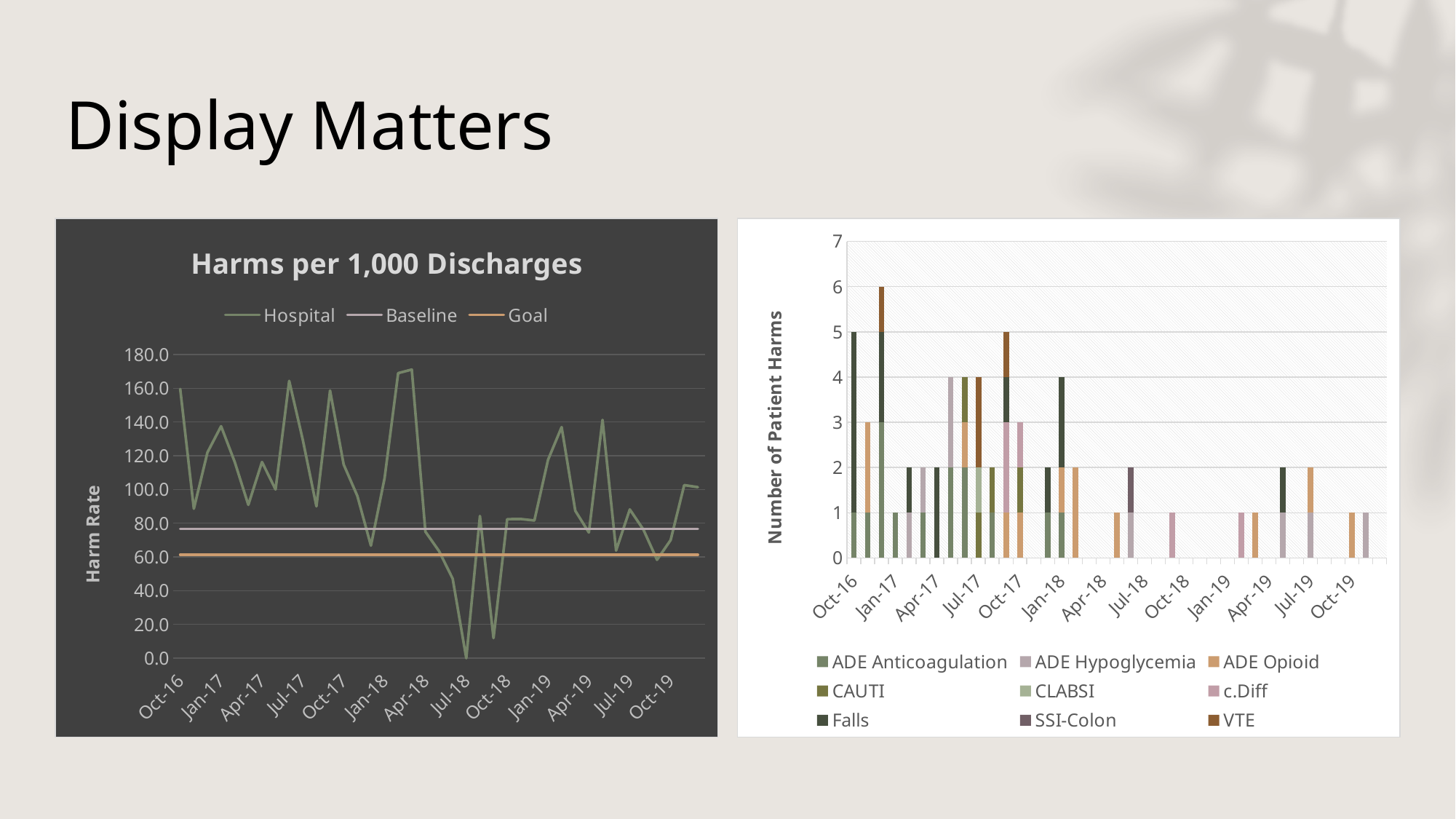
What is the y-axis title of the right chart? Number of Patient Harms In the left chart "Harms per 1,000 Discharges", which is higher, the Baseline line or the Goal line? Baseline In the right chart "Number of Patient Harms", do the stacked bars generally get taller or shorter from Oct-16 to Oct-19? Shorter In the left chart "Harms per 1,000 Discharges", is the Baseline line greater or less than 60? greater How many series does the legend of the right chart "Number of Patient Harms" list? 9 What kind of chart is the right chart with the y-axis "Number of Patient Harms"? Stacked bar chart In the left chart "Harms per 1,000 Discharges", does the Hospital line overall rise or fall from Oct-16 to Oct-19? Fall How many series does the legend of the left chart "Harms per 1,000 Discharges" list? 3 In the left chart "Harms per 1,000 Discharges", is the Hospital value at Oct-16 greater or less than 140? greater In the left chart "Harms per 1,000 Discharges", is the Goal line greater or less than 80? less In the right chart "Number of Patient Harms", what is the total height of the tallest stacked bar? 6 What kind of chart is the left chart titled "Harms per 1,000 Discharges"? Line chart